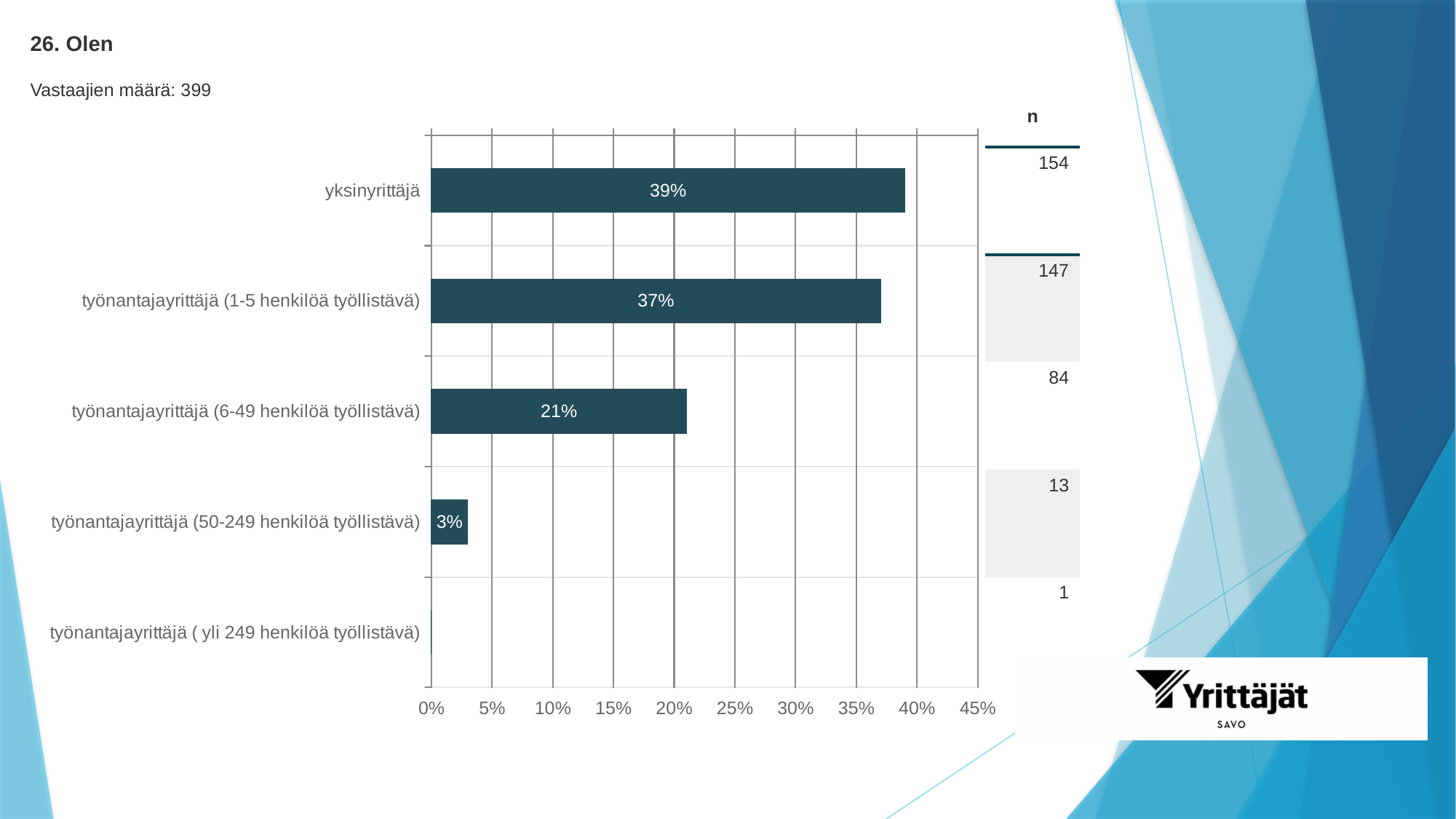
What is the n value shown for työnantajayrittäjä (1-5 henkilöä työllistävä)? 147 Which category has the lowest percentage? työnantajayrittäjä ( yli 249 henkilöä työllistävä) What kind of chart is shown on the slide? bar chart Which category has the highest percentage? yksinyrittäjä What percentage is shown for yksinyrittäjä? 39% What percentage is shown for työnantajayrittäjä (50-249 henkilöä työllistävä)? 3% What is the difference in percentage points between yksinyrittäjä and työnantajayrittäjä (1-5 henkilöä työllistävä)? 2 percentage points Is the value for työnantajayrittäjä (6-49 henkilöä työllistävä) greater or less than 25%? less What percentage is shown for työnantajayrittäjä (6-49 henkilöä työllistävä)? 21% Which is larger: the percentage for työnantajayrittäjä (1-5 henkilöä työllistävä) or for työnantajayrittäjä (6-49 henkilöä työllistävä)? työnantajayrittäjä (1-5 henkilöä työllistävä) What is the total number of respondents (Vastaajien määrä) stated on the slide? 399 How many categories are shown in the chart? 5